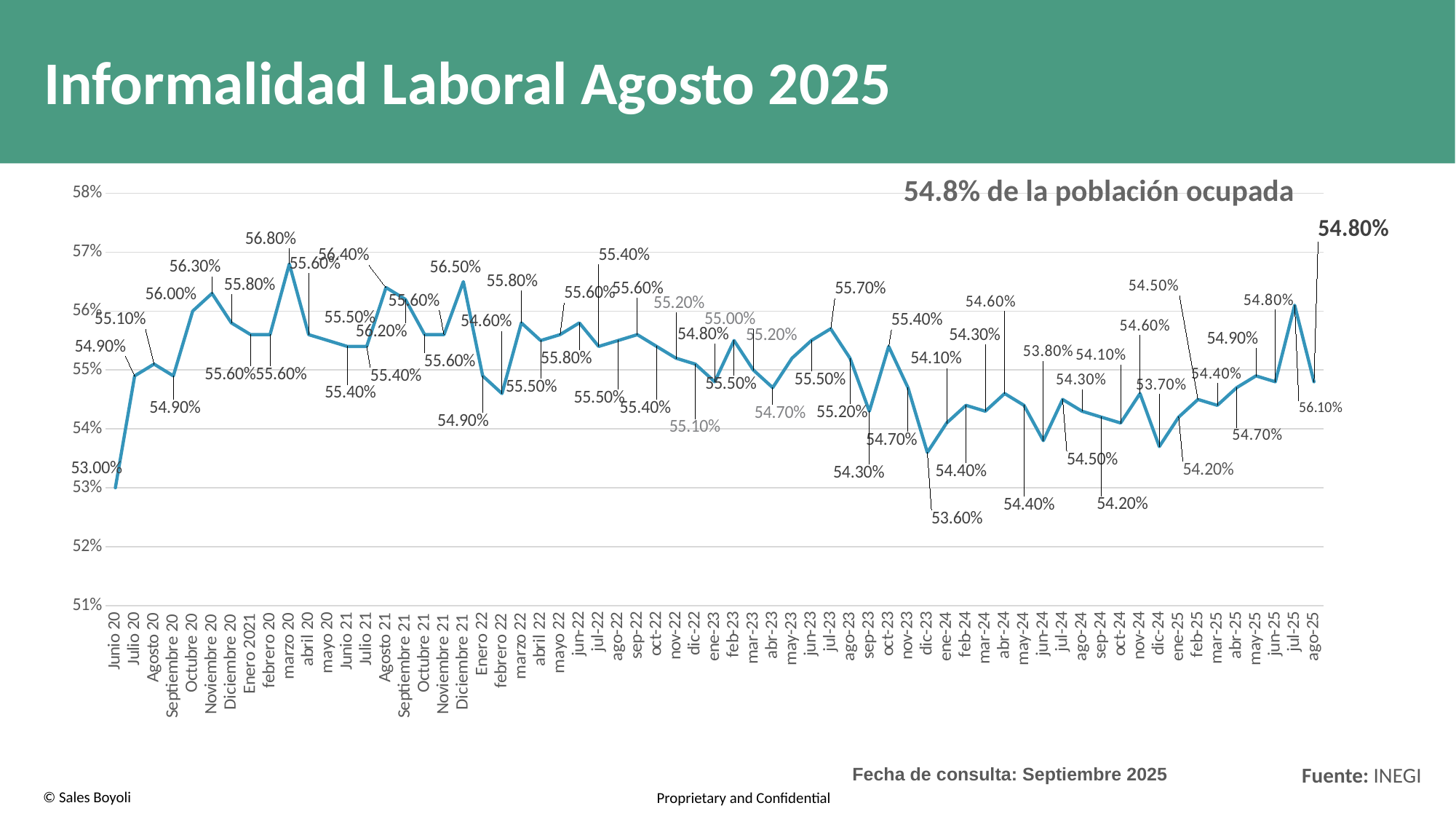
What is the difference between the highest value (marzo 20) and the lowest value (Junio 20)? 3.80% Which month has the highest value? marzo 20 What is the value for jul-25? 56.10% Which month has the lowest value? Junio 20 What is the difference between the values for jul-25 and ago-25? 1.30% What kind of chart is shown on the slide? line chart What is the value for Junio 20? 53.00% Which is larger, the value for jul-25 or the value for ago-25? jul-25 Is the value for dic-23 greater or less than 54%? less What is the value for ago-25? 54.80% What is the title of the slide? Informalidad Laboral Agosto 2025 What is the value for dic-23? 53.60%